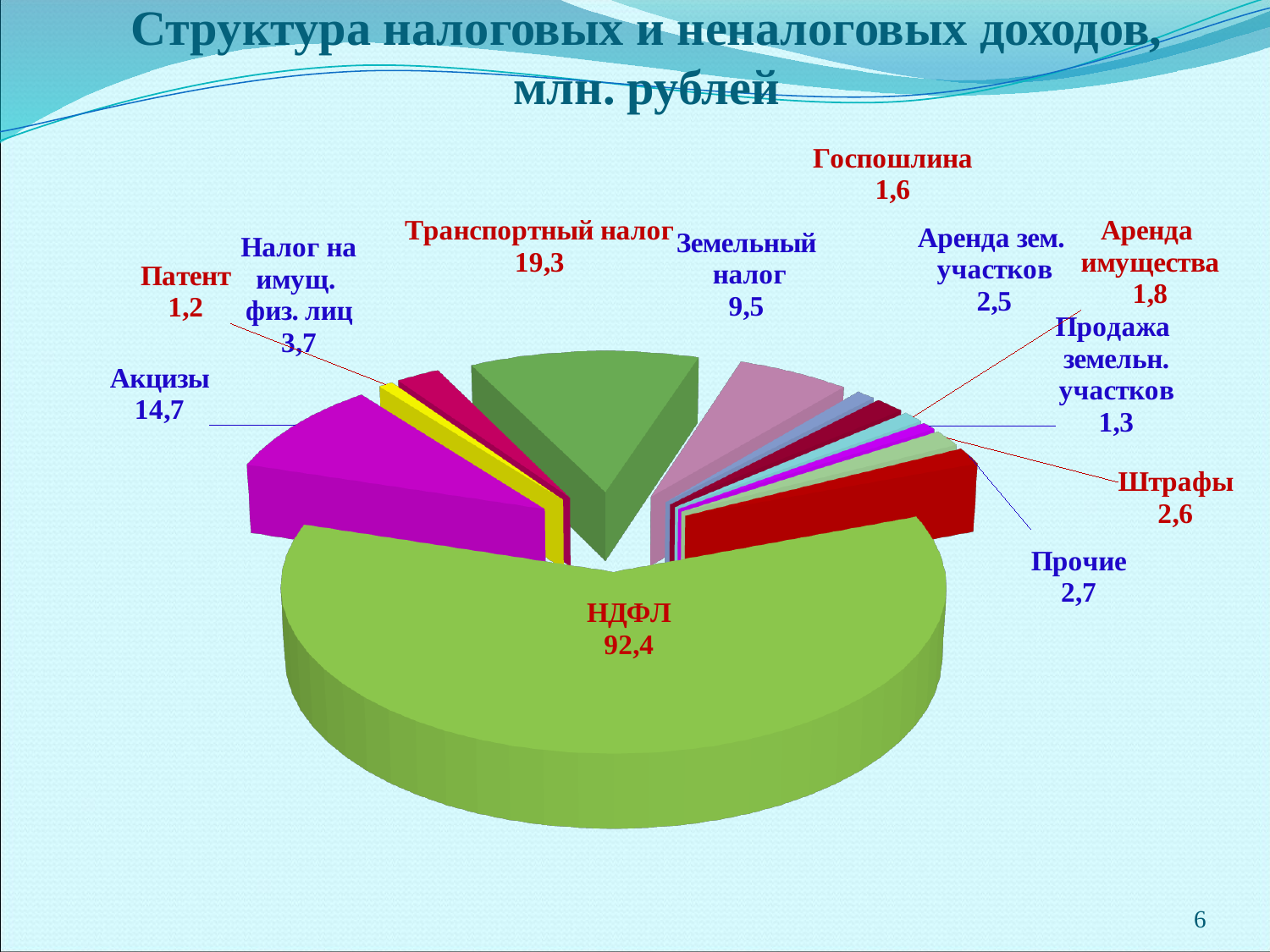
Which is larger, Земельный налог or Налог на имущ. физ. лиц? Земельный налог What is the value for Акцизы? 14,7 What is the title of the chart? Структура налоговых и неналоговых доходов, млн. рублей What type of chart is shown on the slide? Pie chart What is the value for Штрафы? 2,6 What is the value for Транспортный налог? 19,3 Which category has the smallest value? Патент What is the value for Земельный налог? 9,5 What is the difference between Транспортный налог and Акцизы? 4,6 What is the value for НДФЛ? 92,4 How many categories are shown in the pie chart? 12 Which category has the largest value? НДФЛ